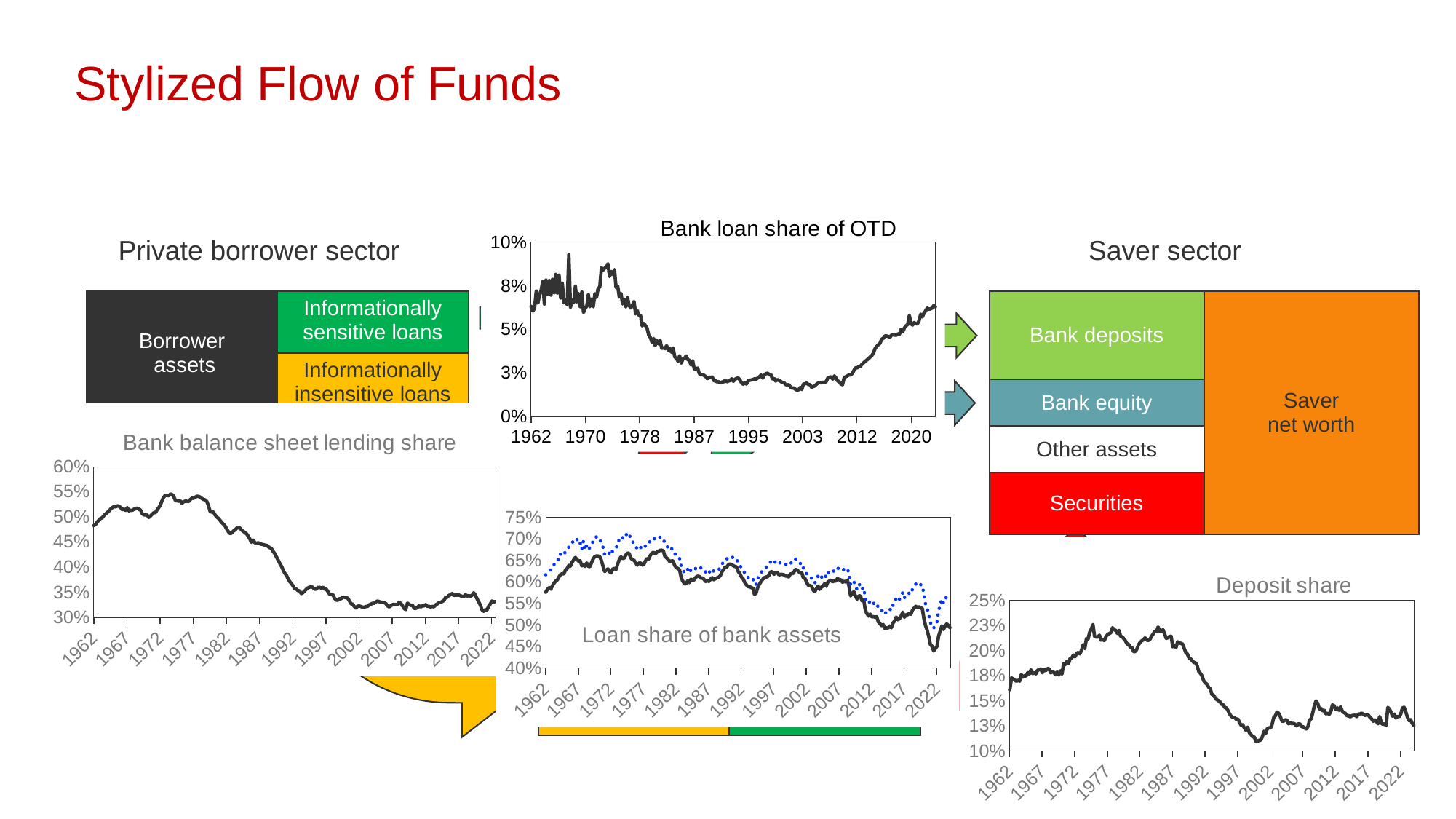
How many lines are plotted in the 'Loan share of bank assets' chart? 2 In the 'Bank balance sheet lending share' chart, does the value overall rise or fall from 1962 to 2022? fall In the 'Deposit share' chart, is the value around 1977 greater or less than 20%? greater What is the highest value shown on the y axis of the 'Bank loan share of OTD' chart? 10% What kind of chart is the 'Bank loan share of OTD' chart? line chart In the 'Bank loan share of OTD' chart, is the value around 1962 greater or less than 5%? greater In the 'Deposit share' chart, is the value around 2002 greater or less than 15%? less In the 'Bank loan share of OTD' chart, does the value rise or fall between 2003 and 2020? rise In the 'Deposit share' chart, does the value rise or fall between 1987 and 2002? fall